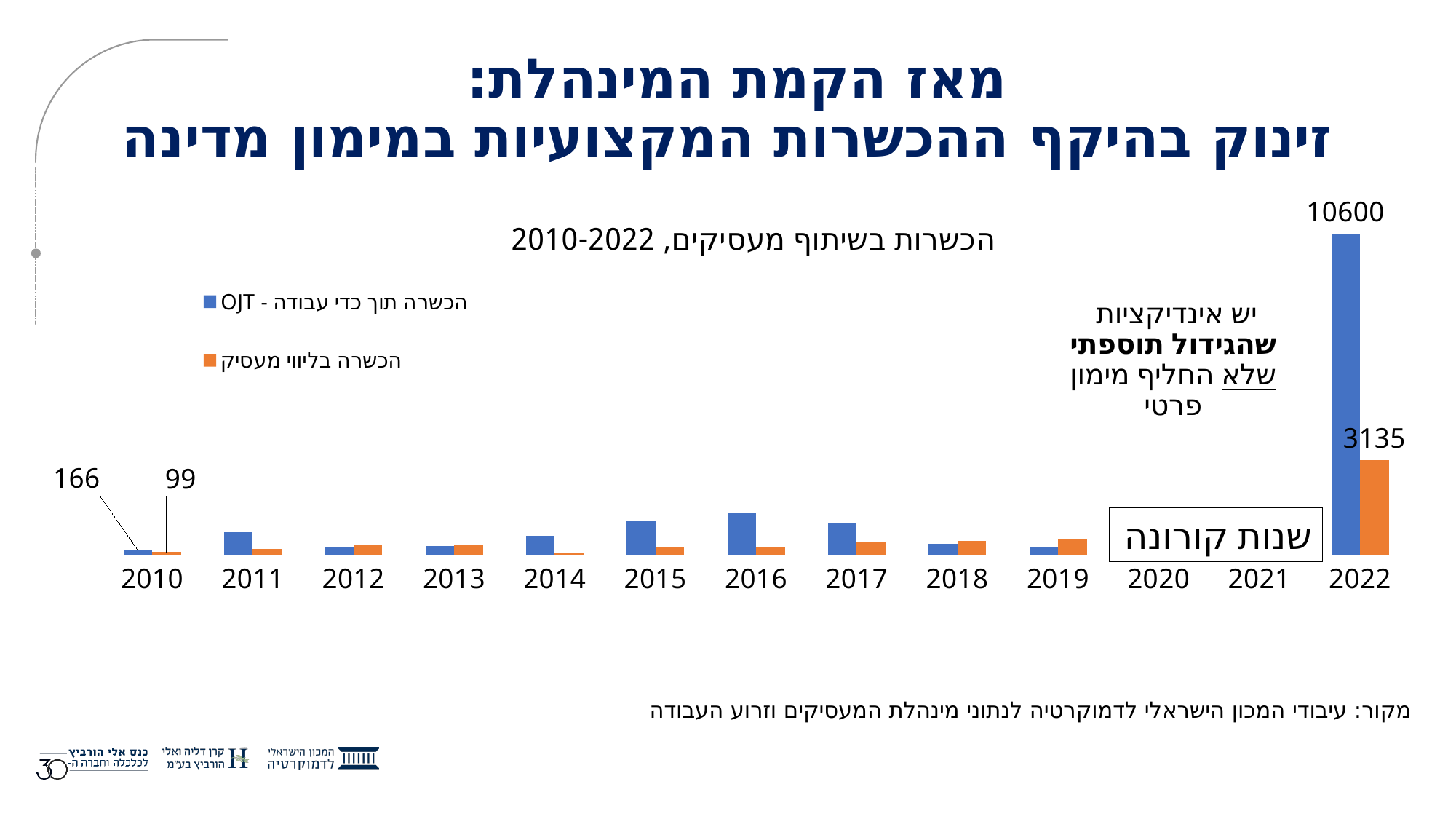
In 2022, which series has the larger value? הכשרה תוך כדי עבודה - OJT What is the value of the הכשרה בליווי מעסיק series in 2022? 3135 What is the difference between the OJT value and the הכשרה בליווי מעסיק value in 2022? 7465 What is the value of the הכשרה בליווי מעסיק series in 2010? 99 What is the title of the chart? הכשרות בשיתוף מעסיקים, 2010-2022 What kind of chart is shown on the slide? Bar chart How many series does the legend list? 2 What is the value of the OJT series (הכשרה תוך כדי עבודה - OJT) in 2022? 10600 What is the difference between the OJT value and the הכשרה בליווי מעסיק value in 2010? 67 In 2019, which series has the larger value? הכשרה בליווי מעסיק What is the value of the OJT series (הכשרה תוך כדי עבודה - OJT) in 2010? 166 In which year is the OJT series (הכשרה תוך כדי עבודה - OJT) highest? 2022